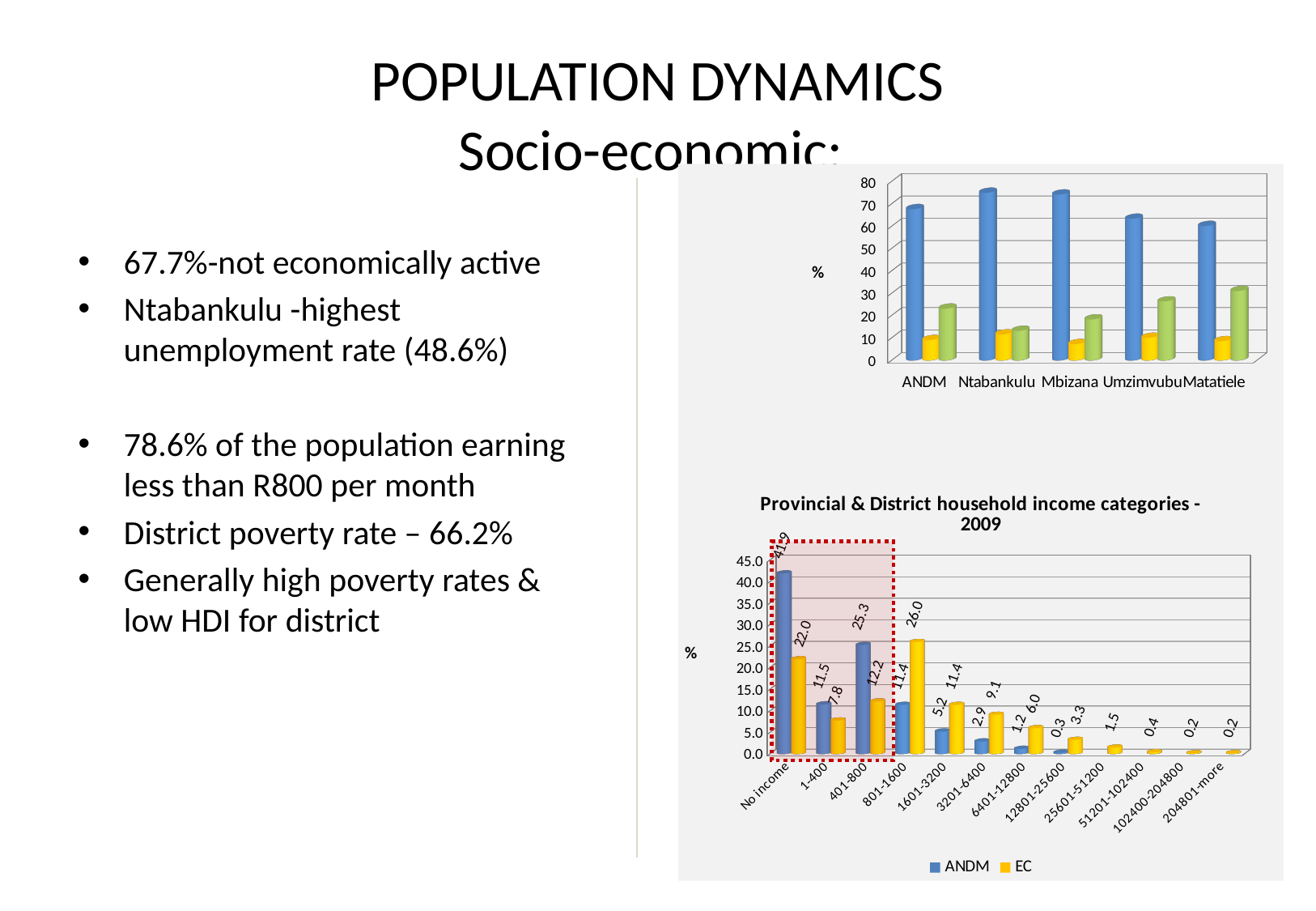
In the bottom chart, 'Provincial & District household income categories - 2009', which is larger for the '1601-3200' category, the ANDM value or the EC value? EC In the bottom chart, 'Provincial & District household income categories - 2009', what is the difference between the ANDM and EC values for the '401-800' category? 13.1 In the bottom chart, 'Provincial & District household income categories - 2009', what is the EC value for the '801-1600' category? 26.0 In the bottom chart, 'Provincial & District household income categories - 2009', which income category has the highest ANDM value? No income In the bottom chart, 'Provincial & District household income categories - 2009', what is the EC value for the '12801-25600' category? 3.3 In the bottom chart, 'Provincial & District household income categories - 2009', what is the ANDM value for the 'No income' category? 41.9 In the top chart, is the value of the blue bar for Ntabankulu greater or less than 70? greater What kind of chart is the top chart on the slide? Bar chart In the bottom chart, 'Provincial & District household income categories - 2009', how many series does the legend list? 2 In the bottom chart, 'Provincial & District household income categories - 2009', how many income categories are shown on the x axis? 12 In the top chart, how many categories are shown on the x axis? 5 In the top chart, is the value of the yellow bar for Mbizana greater or less than 10? less